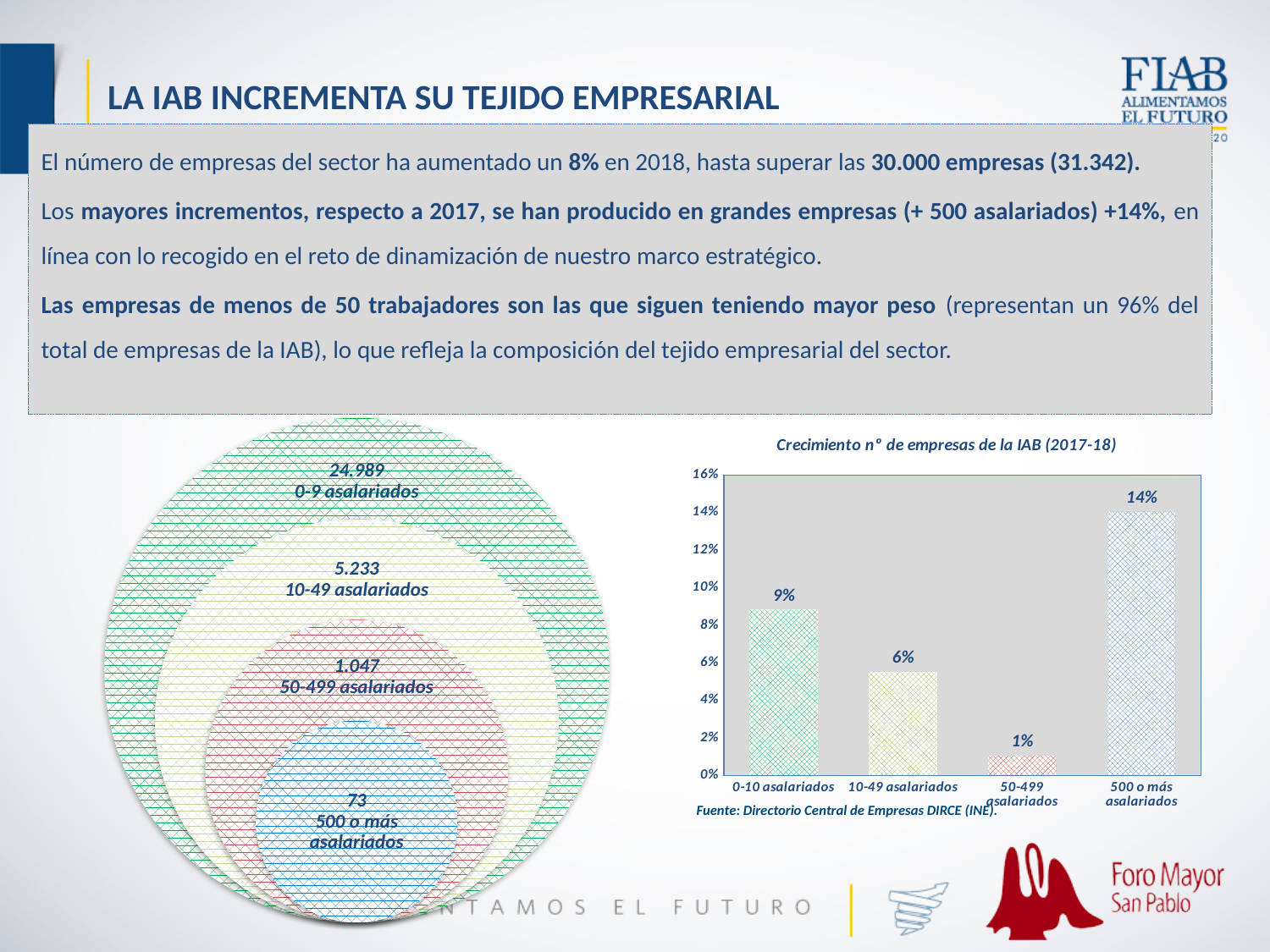
What kind of chart is the one titled 'Crecimiento nº de empresas de la IAB (2017-18)'? Bar chart In the nested circle diagram on the left of the slide, what is the value for '500 o más asalariados'? 73 In the chart titled 'Crecimiento nº de empresas de la IAB (2017-18)', what is the value for '0-10 asalariados'? 9% In the chart titled 'Crecimiento nº de empresas de la IAB (2017-18)', which is larger: the value for '0-10 asalariados' or '10-49 asalariados'? 0-10 asalariados In the chart titled 'Crecimiento nº de empresas de la IAB (2017-18)', which category has the lowest value? 50-499 asalariados In the chart titled 'Crecimiento nº de empresas de la IAB (2017-18)', which category has the highest value? 500 o más asalariados In the nested circle diagram on the left of the slide, what is the difference between the values for '0-9 asalariados' and '10-49 asalariados'? 19.756 In the chart titled 'Crecimiento nº de empresas de la IAB (2017-18)', what is the difference between the values for '500 o más asalariados' and '0-10 asalariados'? 5% In the nested circle diagram on the left of the slide, what is the value for '0-9 asalariados'? 24.989 In the chart titled 'Crecimiento nº de empresas de la IAB (2017-18)', what is the value for '500 o más asalariados'? 14% What is the source cited below the chart titled 'Crecimiento nº de empresas de la IAB (2017-18)'? Directorio Central de Empresas DIRCE (INE) In the chart titled 'Crecimiento nº de empresas de la IAB (2017-18)', how many categories are shown on the x axis? 4